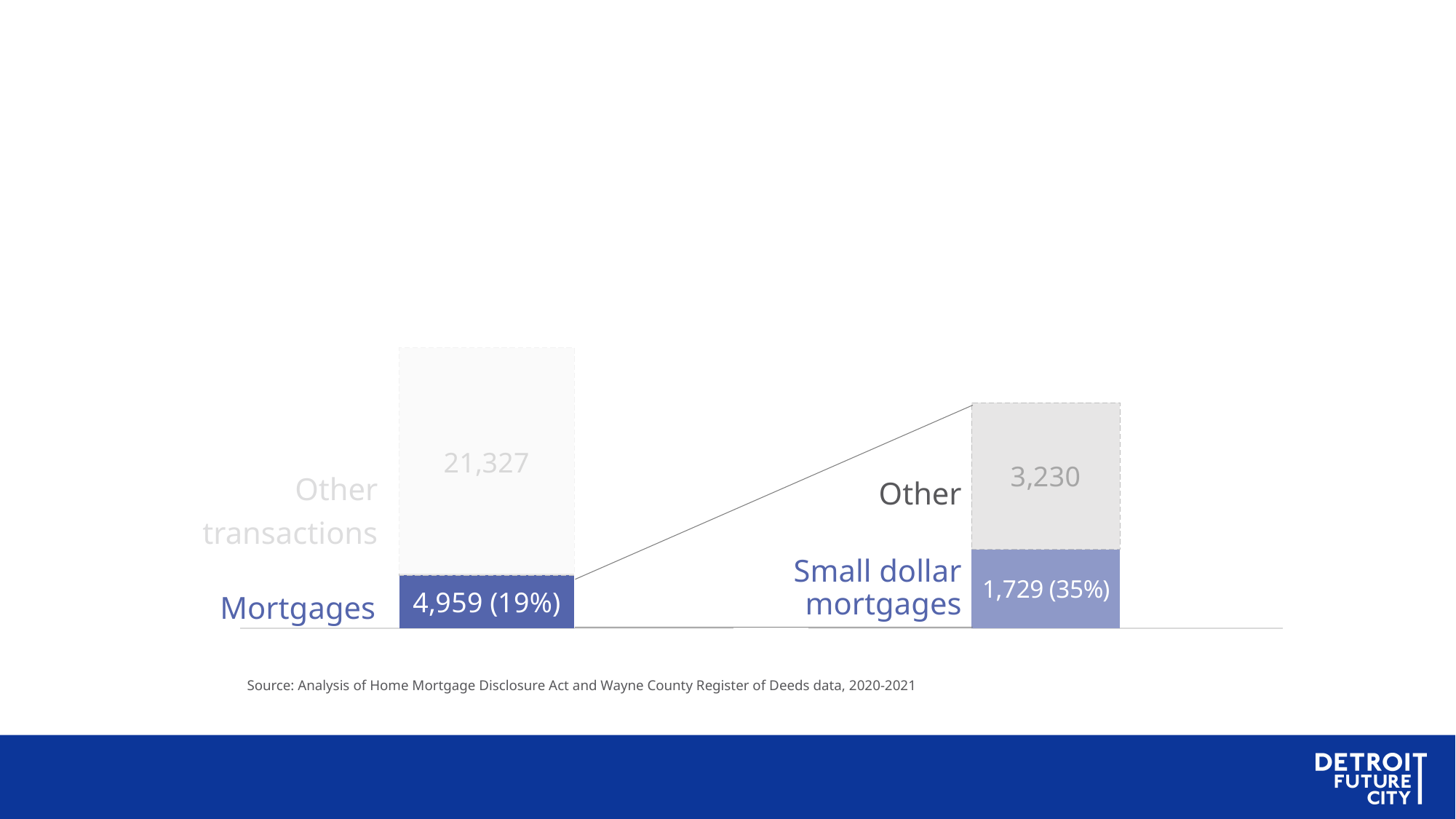
What kind of chart is shown on the slide? Stacked bar chart What is the total of the left stacked bar (Other transactions plus Mortgages)? 26,286 What value is shown for Other in the right stacked bar? 3,230 What value is shown for Small dollar mortgages in the right stacked bar? 1,729 (35%) What percentage of the left bar do Mortgages represent? 19% What value is shown for Other transactions in the left stacked bar? 21,327 Which is larger in the right bar, Other or Small dollar mortgages? Other What value is shown for Mortgages in the left stacked bar? 4,959 (19%) What percentage of the right bar do Small dollar mortgages represent? 35% How many stacked bars are shown on the slide? 2 What is the difference between Other transactions (21,327) and Mortgages (4,959) in the left bar? 16,368 What is the total of the right stacked bar (Other plus Small dollar mortgages)? 4,959